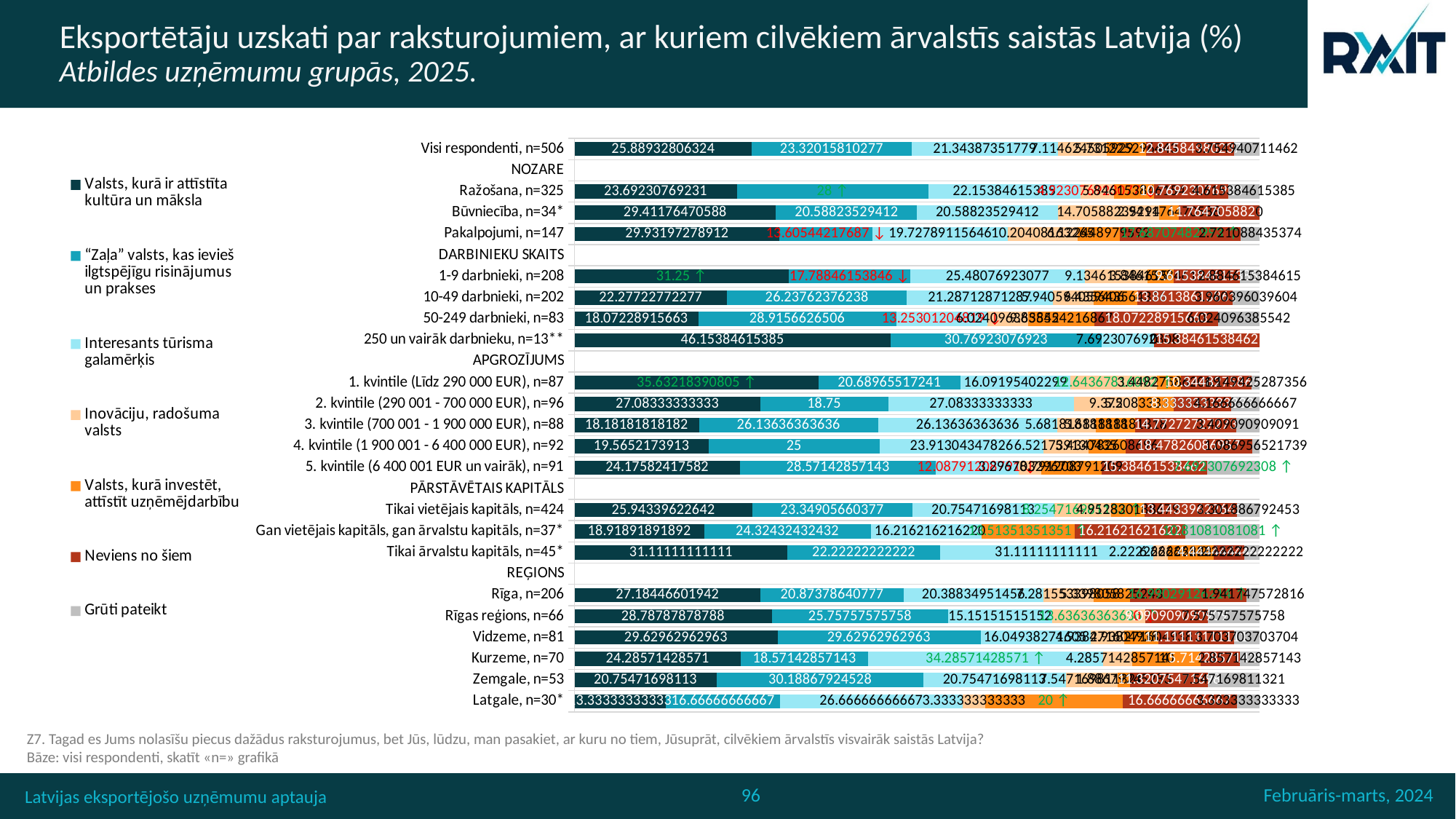
In the 'Zemgale, n=53' row, which is larger: 'Valsts, kurā ir attīstīta kultūra un māksla' or '"Zaļa" valsts, kas ievieš ilgtspējīgu risinājumus un prakses'? "Zaļa" valsts, kas ievieš ilgtspējīgu risinājumus un prakses What type of chart is shown on the slide? Stacked horizontal bar chart How many series does the legend list? 7 What is the value for '"Zaļa" valsts, kas ievieš ilgtspējīgu risinājumus un prakses' in the 'Ražošana, n=325' row? 28 Which group has the highest value for 'Valsts, kurā ir attīstīta kultūra un māksla'? 250 un vairāk darbinieku, n=13** Which group has the lowest value for 'Valsts, kurā ir attīstīta kultūra un māksla'? Latgale, n=30* In the 'Kurzeme, n=70' row, what is the difference between 'Interesants tūrisma galamērķis' and 'Valsts, kurā ir attīstīta kultūra un māksla'? 10 How many groups are listed under the REĢIONS section? 6 What is the value for 'Valsts, kurā ir attīstīta kultūra un māksla' in the 'Visi respondenti, n=506' row? 25.88932806324 What is the value for 'Valsts, kurā ir attīstīta kultūra un māksla' in the '250 un vairāk darbinieku, n=13**' row? 46.15384615385 What is the value for 'Valsts, kurā investēt, attīstīt uzņēmējdarbību' in the 'Latgale, n=30*' row? 20 What is the value for 'Interesants tūrisma galamērķis' in the 'Kurzeme, n=70' row? 34.28571428571